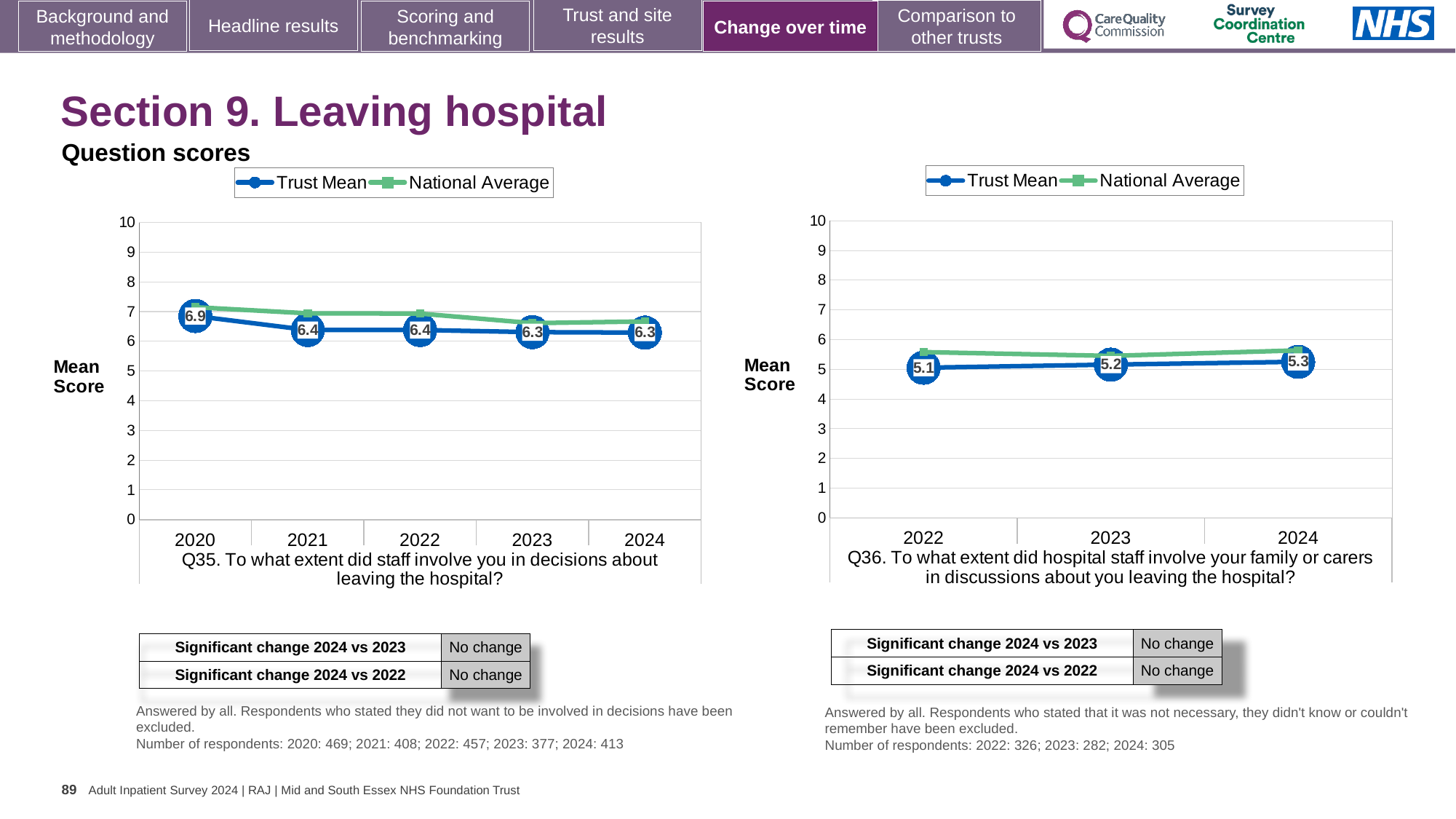
In the Q35 chart on the left, how many years are shown on the x axis? 5 In the Q35 chart on the left, does the Trust Mean rise or fall from 2020 to 2024? fall In the Q35 chart on the left, which year has the highest Trust Mean? 2020 In the Q35 chart on the left, what is the Trust Mean for 2024? 6.3 How many series does the legend of the Q36 chart on the right list? 2 What kind of chart is the Q35 chart on the left? line chart In the Q36 chart on the right, which year has the lowest Trust Mean? 2022 In the Q36 chart on the right, is the National Average for 2022 greater or less than 6? less In the Q36 chart on the right, what is the Trust Mean for 2024? 5.3 In the Q35 chart on the left, what is the difference between the Trust Mean for 2020 and for 2021? 0.5 In the Q36 chart on the right, what is the Trust Mean for 2022? 5.1 In the Q35 chart on the left, what is the Trust Mean for 2020? 6.9